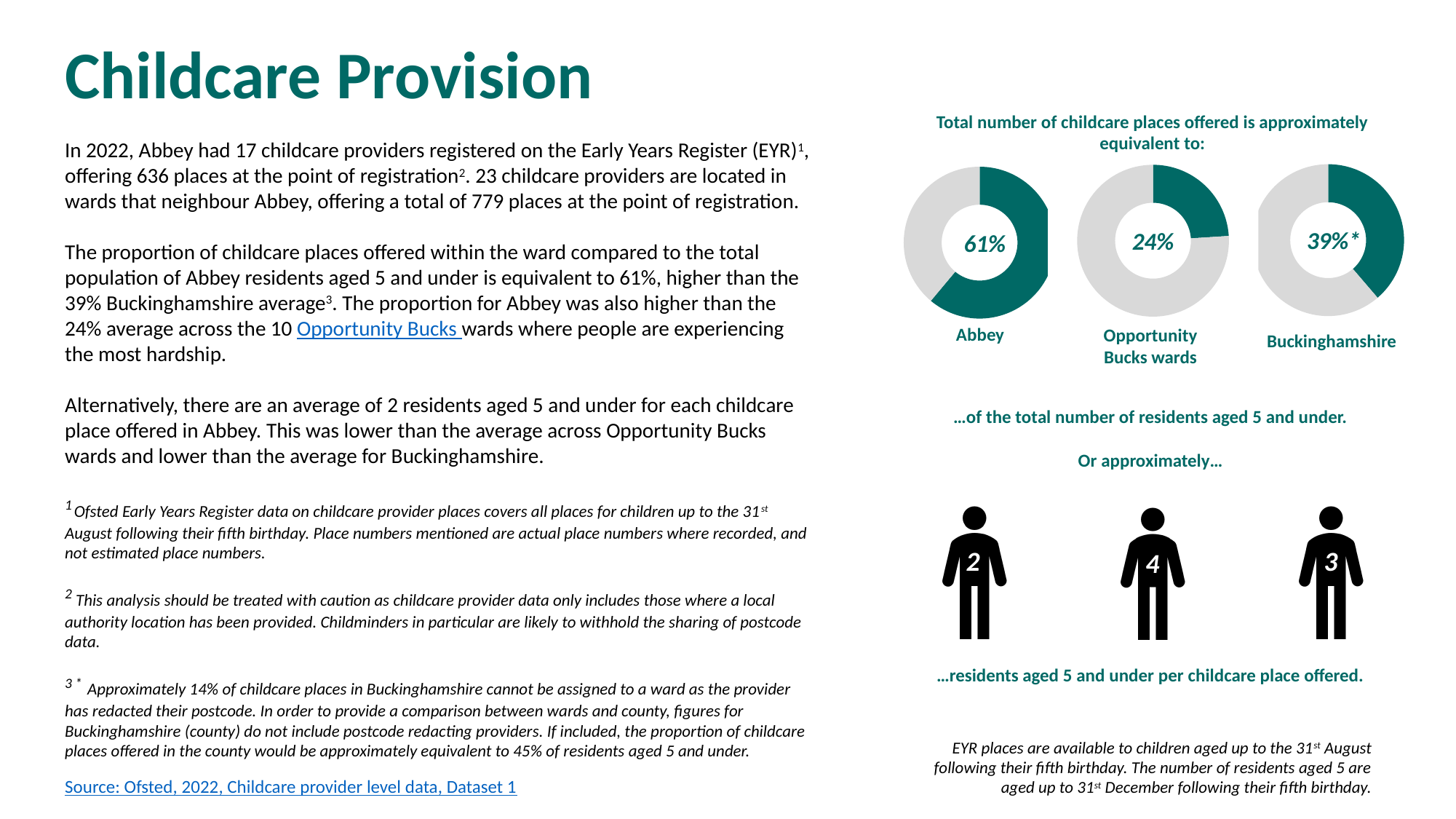
In the person icons, how many residents aged 5 and under per childcare place are shown for Opportunity Bucks wards? 4 How many donut charts are shown on the slide? 3 In the donut charts, what is the difference in percentage points between Buckinghamshire and Opportunity Bucks wards? 15 percentage points Which of the three donut charts shows the lowest percentage? Opportunity Bucks wards In the donut charts, what percentage is shown for Buckinghamshire? 39% In the donut charts, which has the larger percentage, Abbey or Buckinghamshire? Abbey In the donut charts, what percentage is shown for Abbey? 61% What is the title above the three donut charts? Total number of childcare places offered is approximately equivalent to: In the donut charts, what percentage is shown for Opportunity Bucks wards? 24% Which of the three donut charts shows the highest percentage? Abbey In the donut charts, what is the difference in percentage points between Abbey and Buckinghamshire? 22 percentage points What kind of chart is used to show the 61%, 24% and 39% values? Donut chart